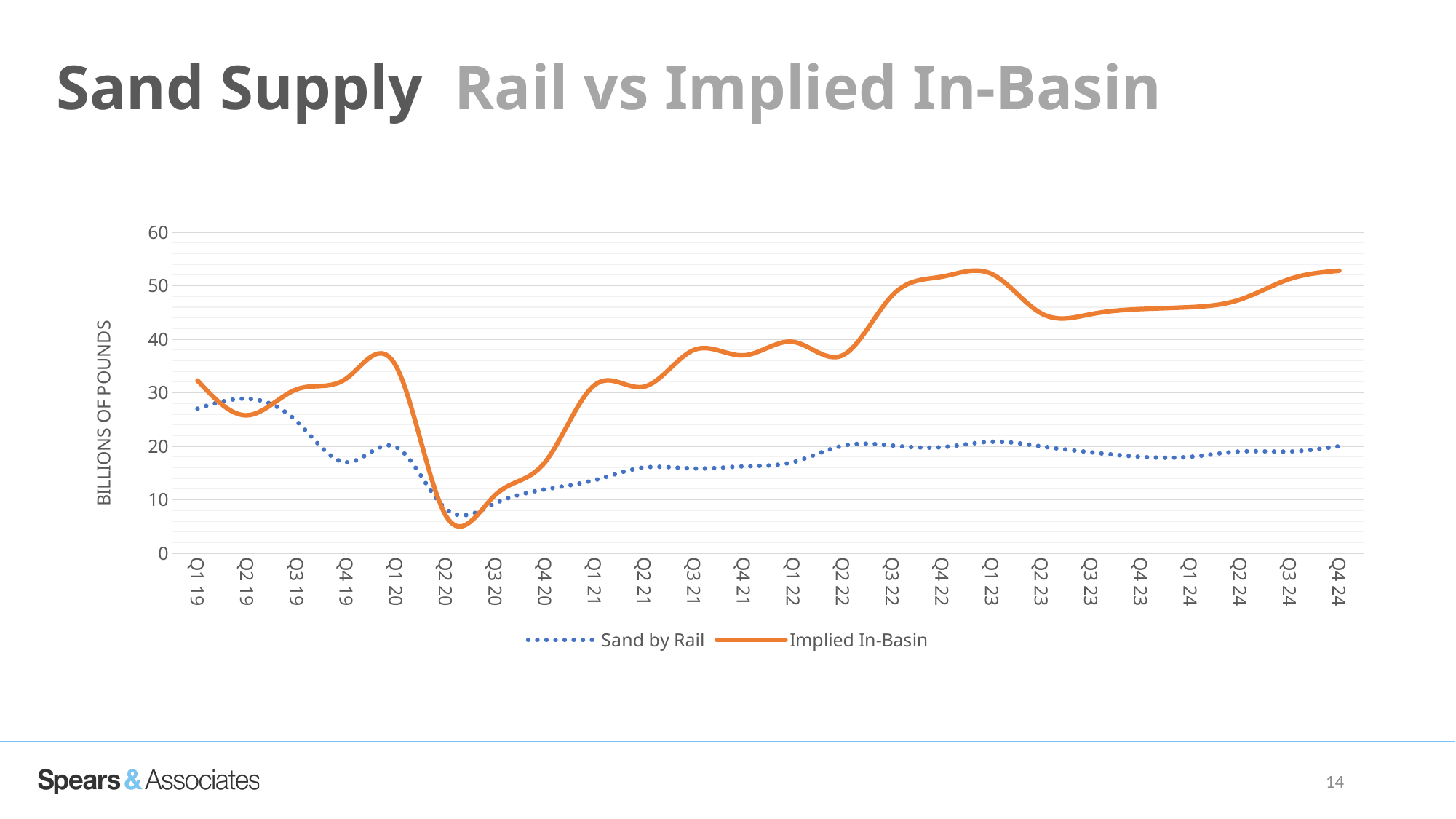
Is the value for Sand by Rail at Q4 24 greater or less than 30? less Is the value for Implied In-Basin at Q3 22 greater or less than 40? greater At Q2 19, which series has the higher value, Sand by Rail or Implied In-Basin? Sand by Rail Does the Implied In-Basin series rise or fall from Q2 20 to Q1 21? rise Is the value for Implied In-Basin at Q4 24 greater or less than 50? greater What kind of chart is shown on the slide? line chart What is the label on the vertical axis? BILLIONS OF POUNDS At Q4 24, which series has the higher value, Sand by Rail or Implied In-Basin? Implied In-Basin In which quarter does the Implied In-Basin series reach its lowest value? Q2 20 How many quarters are plotted along the x axis? 24 How many series does the legend list? 2